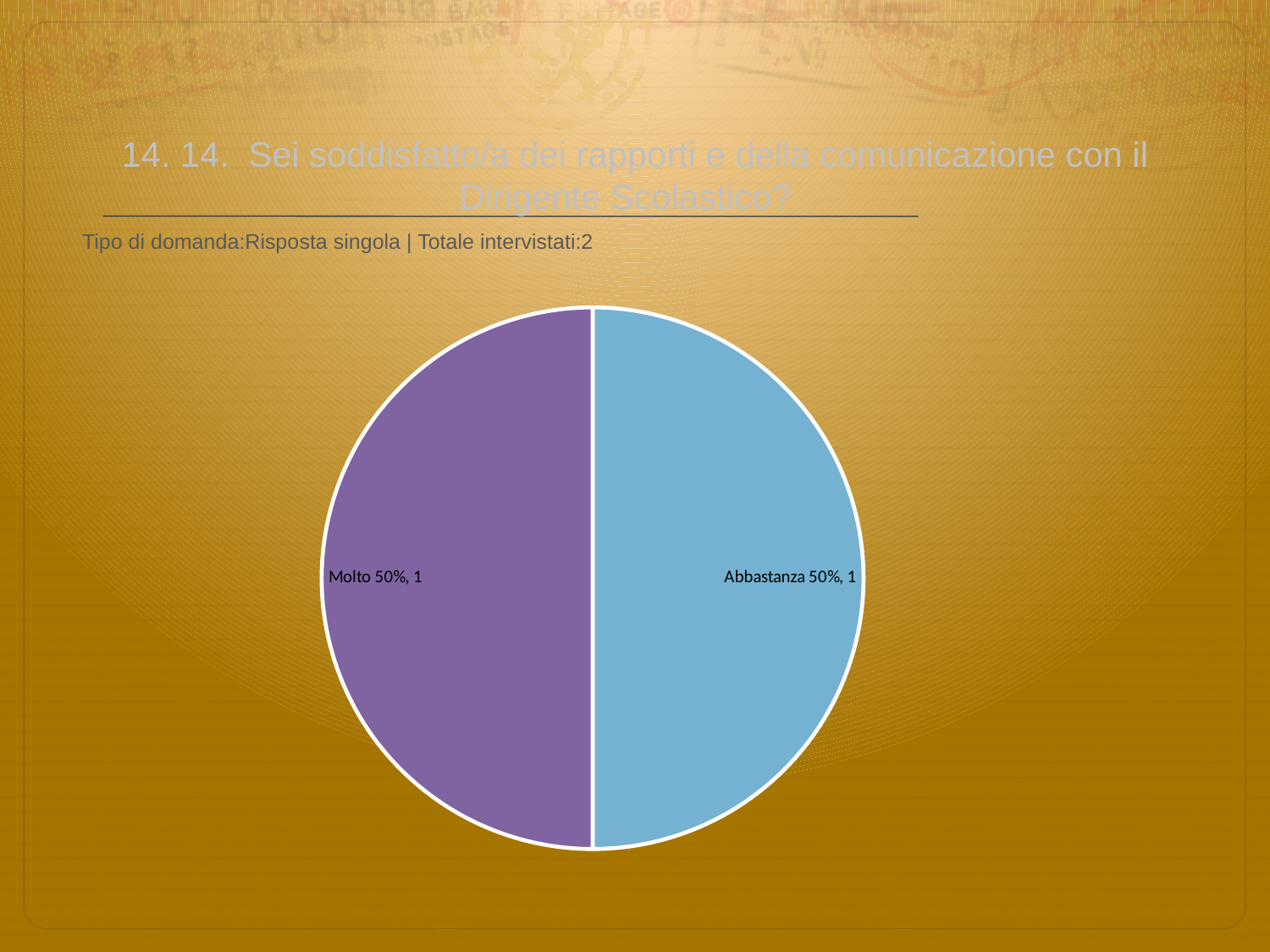
What share of the pie does the Abbastanza slice represent? 50% What colour is the Molto slice? purple What is the count value shown for Abbastanza? 1 What is the difference between the values for Molto and Abbastanza? 0 What colour is the Abbastanza slice? light blue What is the total of the values for Molto and Abbastanza? 2 What kind of chart is shown on the slide? pie chart What is the count value shown for Molto? 1 How many slices does the pie chart have? 2 What share of the pie does the Molto slice represent? 50%